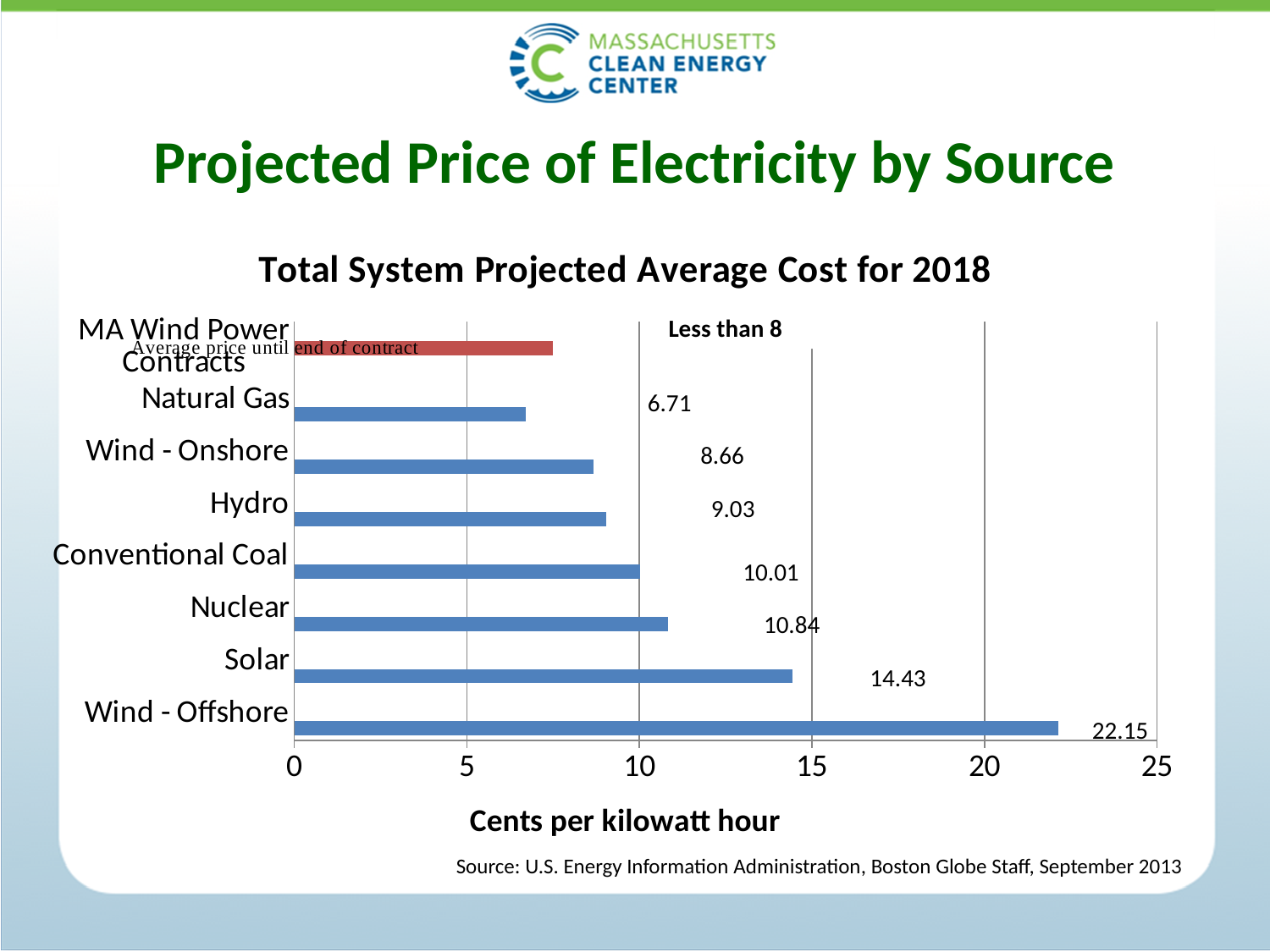
What is the projected cost for Hydro? 9.03 What is the title of the x axis? Cents per kilowatt hour What is the difference between the projected costs of Wind - Offshore and Solar? 7.72 How many sources are listed in the chart? 8 Which has a higher projected cost, Solar or Nuclear? Solar What is the projected cost for Wind - Offshore? 22.15 What is the projected cost for Nuclear? 10.84 What is the difference between the projected costs of Nuclear and Conventional Coal? 0.83 What type of chart is shown on the slide? Bar chart Is the value for MA Wind Power Contracts greater or less than 10? less Which source has the highest projected cost? Wind - Offshore What is the projected cost for Natural Gas? 6.71